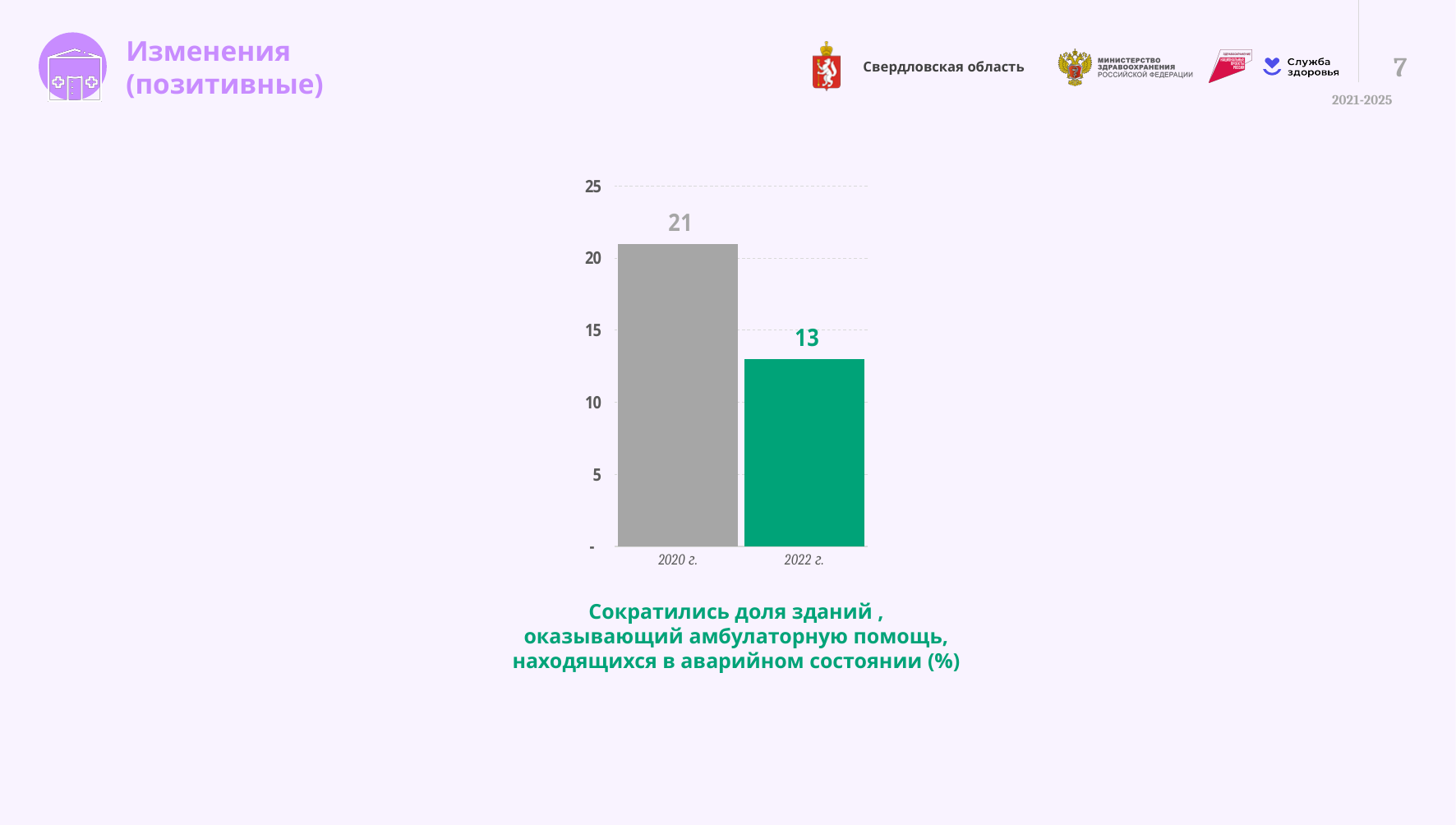
Which year has the lowest value? 2022 г. What is the value for 2020 г.? 21 Is the value for 2022 г. greater or less than 15? less Do the values rise or fall from 2020 г. to 2022 г.? fall Which year has the highest value? 2020 г. How many categories are shown on the x axis? 2 What colour is the bar for 2022 г.? green What is the difference between the values for 2020 г. and 2022 г.? 8 What is the value for 2022 г.? 13 Is the value for 2020 г. greater or less than 20? greater What kind of chart is shown on the slide? bar chart Which is larger, the value for 2020 г. or the value for 2022 г.? 2020 г.